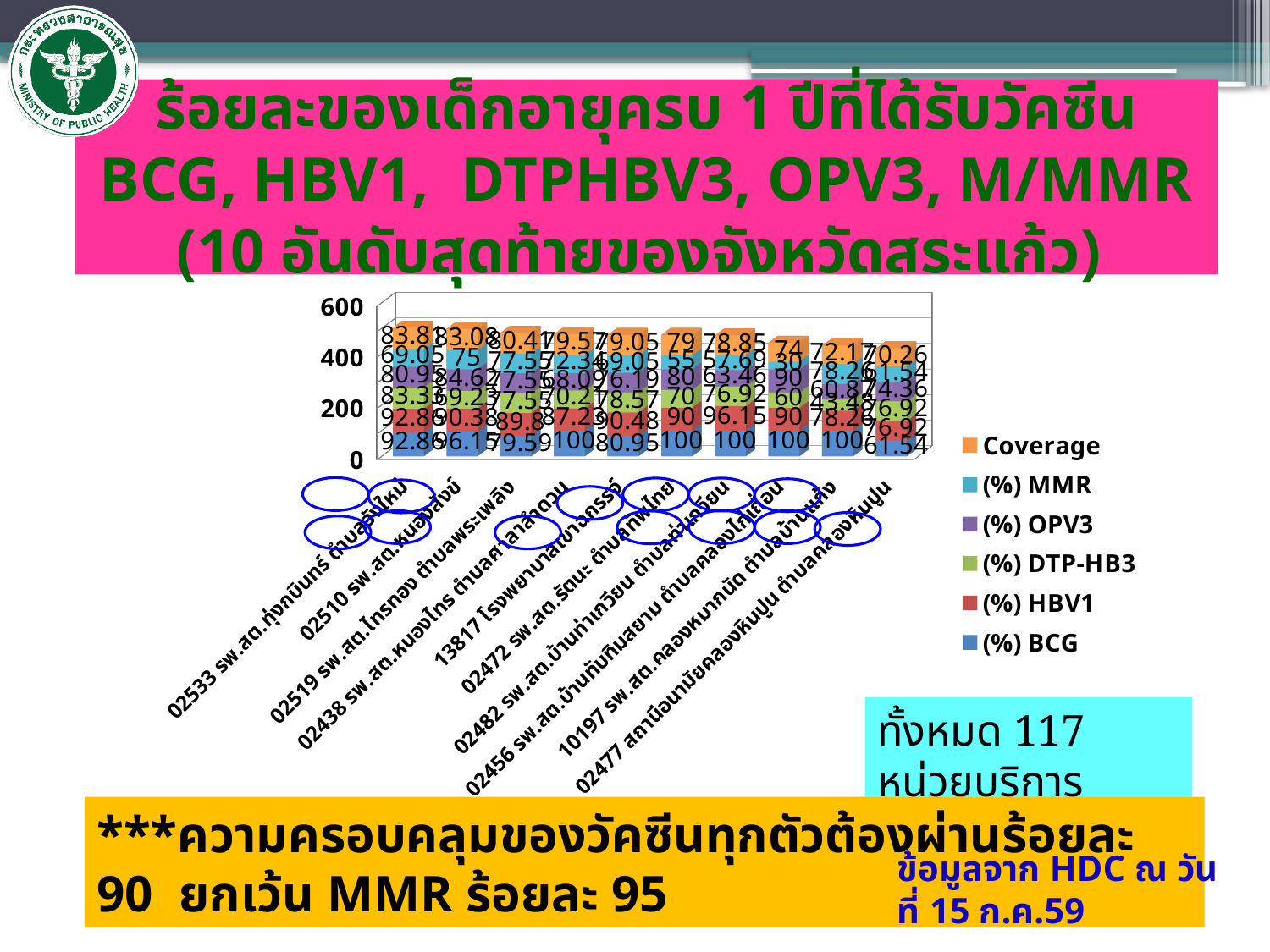
What is the highest tick value shown on the chart's vertical axis? 600 How many service units (categories) are shown on the x axis of the chart? 10 What is the Coverage value for 02477 สถานีอนามัยคลองหินปูน ตำบลคลองหินปูน? 70.26 What is the (%) BCG value for 02510 รพ.สต.หนองสังข์? 96.15 What kind of chart is shown on the slide? bar chart What is the (%) BCG value for 02438 รพ.สต.หนองไทร ตำบลศาลาลำดวน? 100 What is the (%) BCG value for 02477 สถานีอนามัยคลองหินปูน ตำบลคลองหินปูน? 61.54 How many series does the chart legend list? 6 Which series is listed first (at the top) in the chart legend? Coverage Which service unit has the highest Coverage value? 02533 รพ.สต.ทุ่งกบินทร์ Which has the larger Coverage value: 02533 รพ.สต.ทุ่งกบินทร์ or 02477 สถานีอนามัยคลองหินปูน? 02533 รพ.สต.ทุ่งกบินทร์ Which service unit has the lowest Coverage value? 02477 สถานีอนามัยคลองหินปูน ตำบลคลองหินปูน